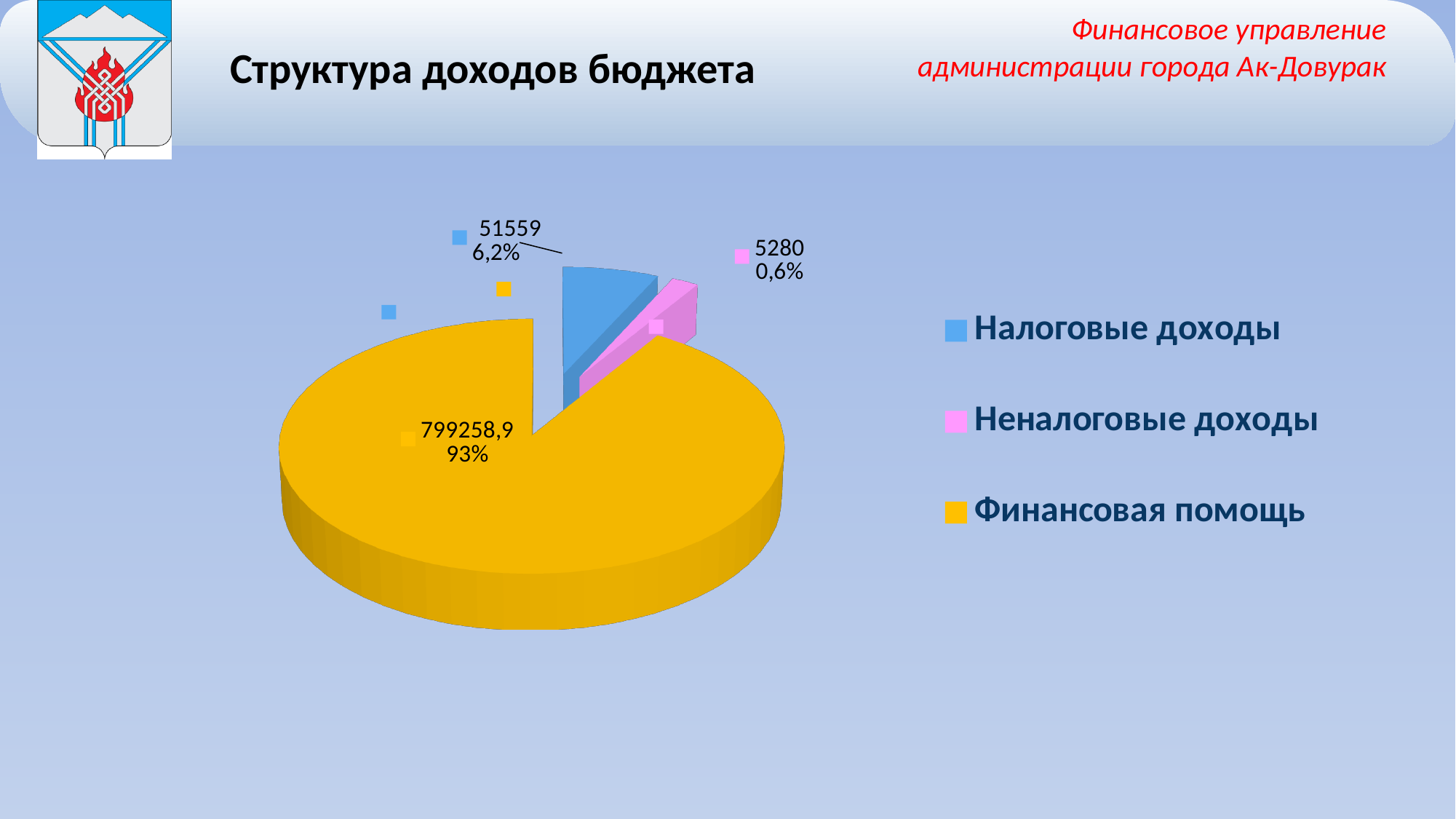
How many categories does the legend list? 3 Which category has the largest slice? Финансовая помощь What is the value for Неналоговые доходы? 5280 What share of the pie does Финансовая помощь take? 93% What share of the pie does Налоговые доходы take? 6,2% What kind of chart is shown on the slide? pie chart What share of the pie does Неналоговые доходы take? 0,6% What is the difference between the values for Налоговые доходы and Неналоговые доходы? 46279 What is the value for Финансовая помощь? 799258,9 What is the value for Налоговые доходы? 51559 Which category has the smallest slice? Неналоговые доходы Which is larger, Налоговые доходы or Неналоговые доходы? Налоговые доходы